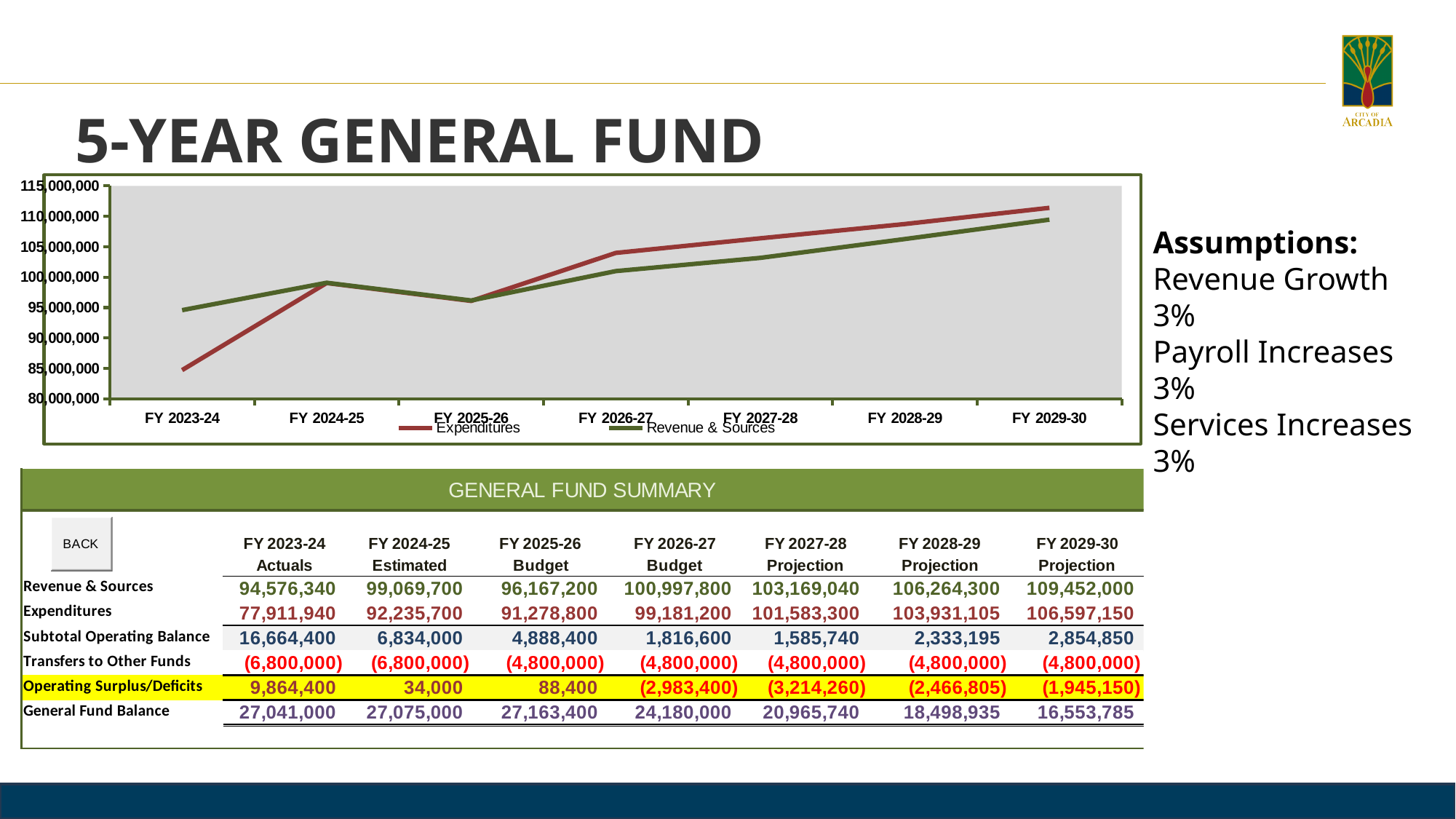
What is the Revenue & Sources value for FY 2023-24? 94,576,340 How many fiscal years are plotted along the x axis of the chart? 7 In which fiscal year is the Expenditures line at its lowest? FY 2023-24 What kind of chart is shown on the slide? line chart Is the Expenditures value for FY 2029-30 greater or less than 105,000,000? greater What is the Revenue & Sources value for FY 2029-30? 109,452,000 How many series does the chart legend list? 2 In FY 2026-27, which line is higher, Expenditures or Revenue & Sources? Expenditures Is the Expenditures value for FY 2023-24 greater or less than 90,000,000? less What colour is the Expenditures line in the chart? red Does the Expenditures line rise or fall from FY 2023-24 to FY 2024-25? rise In FY 2023-24, which line is higher, Expenditures or Revenue & Sources? Revenue & Sources